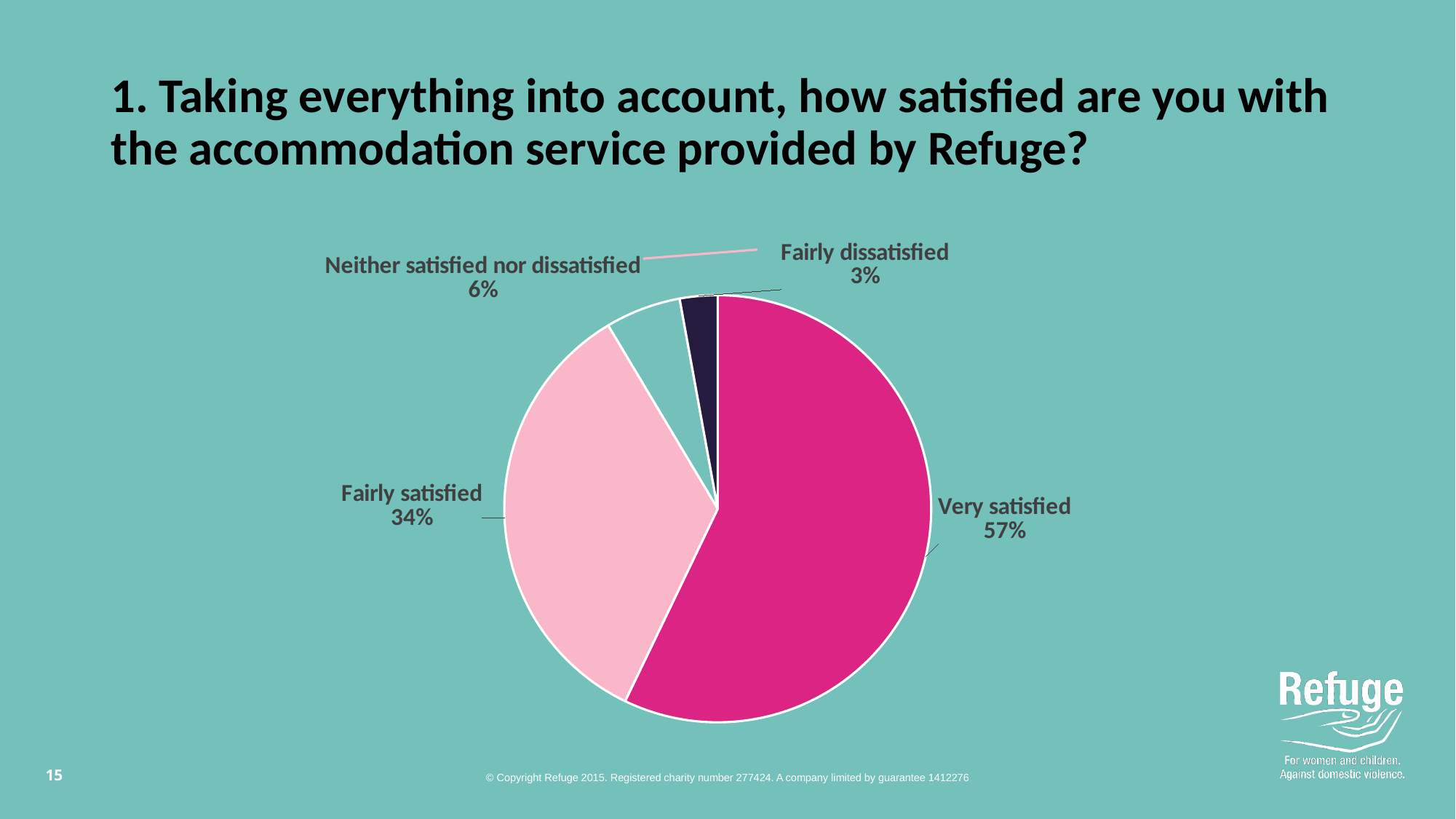
What percentage of respondents were fairly dissatisfied? 3% Which is larger: the share for Neither satisfied nor dissatisfied or the share for Fairly dissatisfied? Neither satisfied nor dissatisfied What is the difference in percentage points between Very satisfied and Fairly satisfied? 23 What kind of chart is shown on the slide? pie chart What percentage of respondents were fairly satisfied? 34% What percentage of respondents were very satisfied with the accommodation service? 57% What is the combined percentage of respondents who were very satisfied or fairly satisfied? 91% What colour is the Very satisfied slice of the pie? magenta (dark pink) Which response category has the largest share of the pie? Very satisfied What percentage of respondents were neither satisfied nor dissatisfied? 6% How many response categories are shown in the pie chart? 4 Which response category has the smallest share of the pie? Fairly dissatisfied